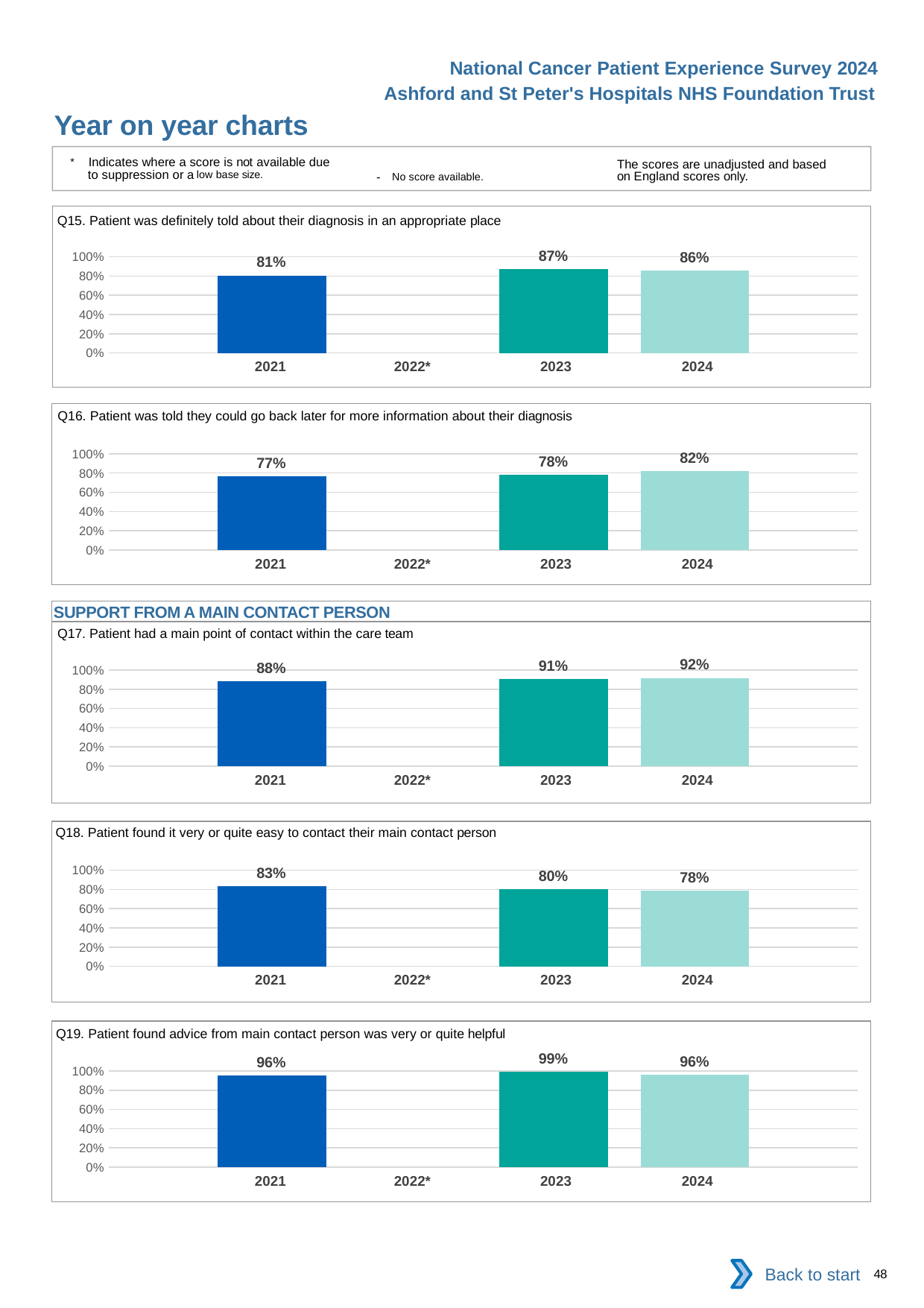
In the Q15 chart (Patient was definitely told about their diagnosis in an appropriate place), what is the value for 2023? 87% In the Q17 chart (Patient had a main point of contact within the care team), what is the difference between the 2024 and 2021 values? 4 percentage points In the Q15 chart, what is the difference between the 2023 and 2021 values? 6 percentage points In the Q18 chart (Patient found it very or quite easy to contact their main contact person), which year has the lowest value? 2024 In the Q16 chart, what is the value for 2021? 77% How many year categories are shown on the x axis of the Q17 chart? 4 In the Q18 chart, is the value for 2021 larger or smaller than the value for 2023? larger In the Q16 chart (Patient was told they could go back later for more information about their diagnosis), which year has the highest value? 2024 What type of chart is used for Q19? bar chart In the Q15 chart, which year has no bar shown? 2022* In the Q19 chart (Patient found advice from main contact person was very or quite helpful), what is the value for 2023? 99% In the Q18 chart, do the values rise or fall from 2021 to 2024? fall